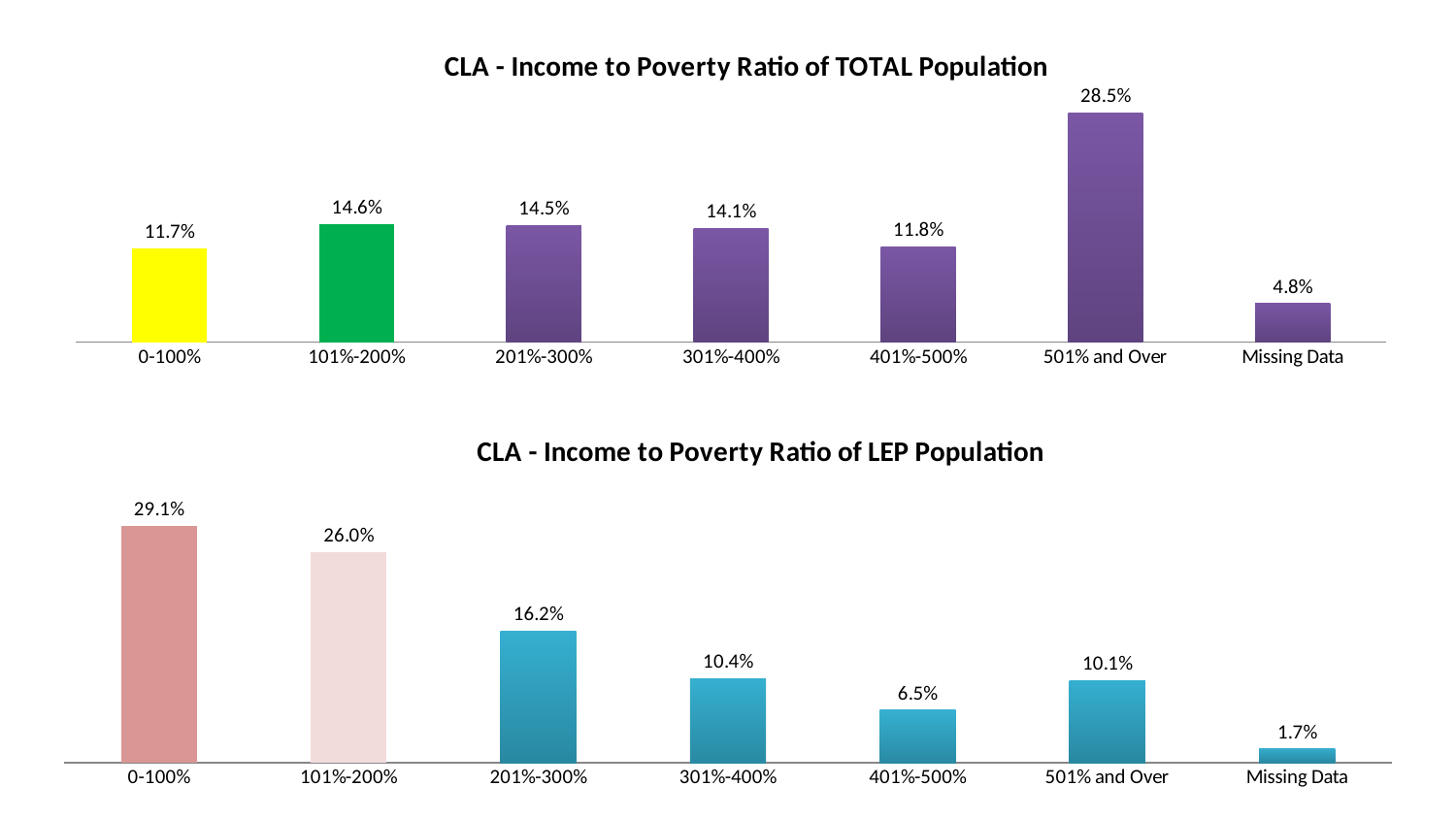
In the 'CLA - Income to Poverty Ratio of LEP Population' chart, which category has the highest value? 0-100% In the 'CLA - Income to Poverty Ratio of TOTAL Population' chart, which is larger: the value for 0-100% or the value for 101%-200%? 101%-200% In the 'CLA - Income to Poverty Ratio of TOTAL Population' chart, what is the difference between the values for 501% and Over and Missing Data? 23.7% In the 'CLA - Income to Poverty Ratio of TOTAL Population' chart, what is the value for 501% and Over? 28.5% In the 'CLA - Income to Poverty Ratio of TOTAL Population' chart, what colour is the bar for 101%-200%? Green What kind of chart is the 'CLA - Income to Poverty Ratio of TOTAL Population' chart? Bar chart In the 'CLA - Income to Poverty Ratio of LEP Population' chart, what is the difference between the values for 0-100% and 101%-200%? 3.1% How many categories are shown in the 'CLA - Income to Poverty Ratio of LEP Population' chart? 7 In the 'CLA - Income to Poverty Ratio of LEP Population' chart, which is larger: the value for 201%-300% or the value for 501% and Over? 201%-300% In the 'CLA - Income to Poverty Ratio of LEP Population' chart, what is the value for 0-100%? 29.1% In the 'CLA - Income to Poverty Ratio of TOTAL Population' chart, which category has the lowest value? Missing Data In the 'CLA - Income to Poverty Ratio of LEP Population' chart, what is the value for Missing Data? 1.7%